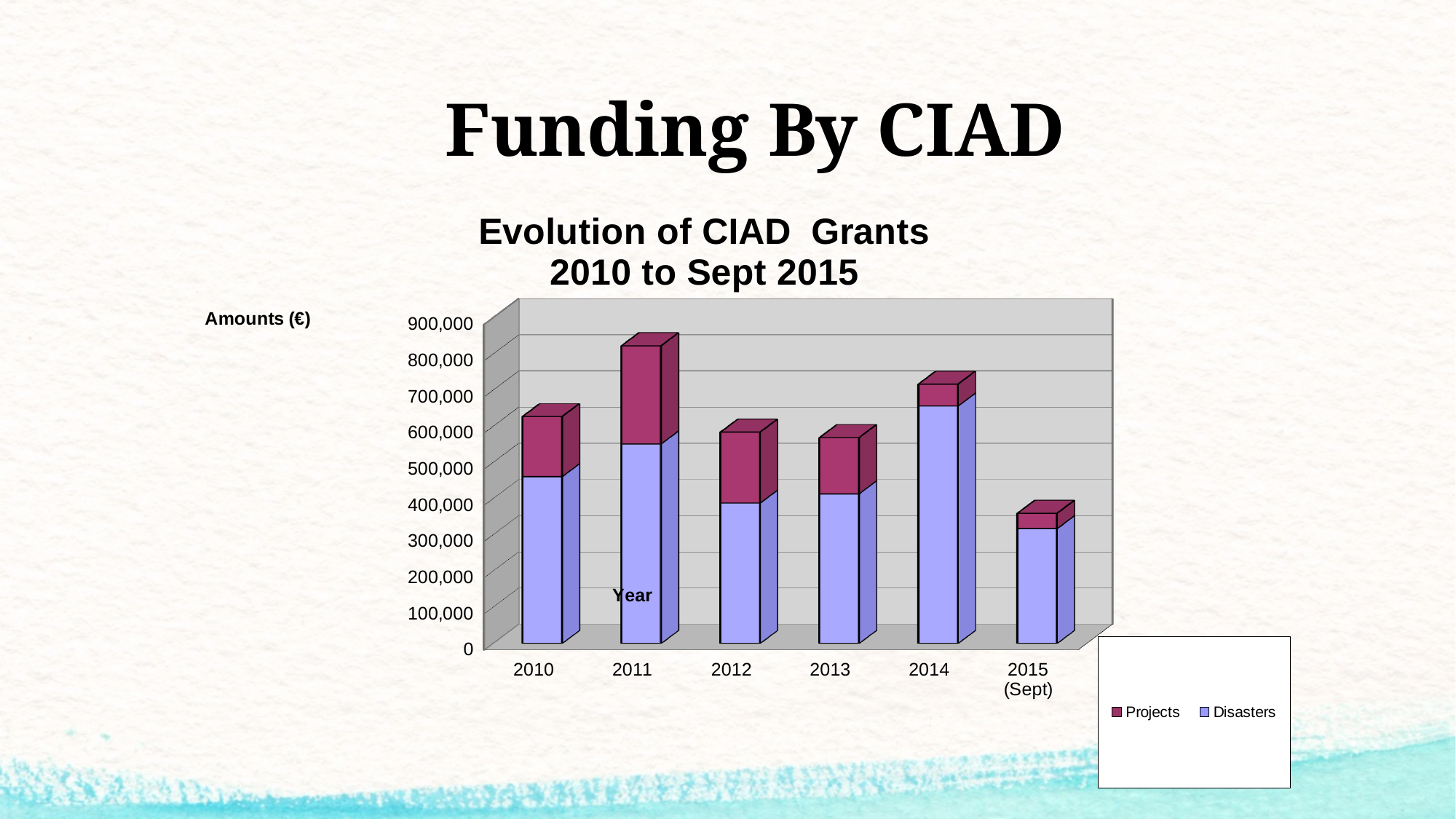
Which year has the highest total grant amount? 2011 How many years (categories) are shown on the x axis of the chart? 6 Does the total grant amount rise or fall from 2014 to 2015 (Sept)? fall Which year has the larger total grant amount, 2012 or 2014? 2014 How many series does the legend list? 2 What is the title of the chart? Evolution of CIAD Grants 2010 to Sept 2015 Is the total grant amount for 2015 (Sept) greater or less than 400,000? less Which year has the lowest total grant amount? 2015 (Sept) Is the total grant amount for 2011 greater or less than 700,000? greater Is the Disasters amount for 2014 greater or less than 600,000? greater Which year has the highest Disasters amount? 2014 What kind of chart is shown on the slide? Stacked bar chart